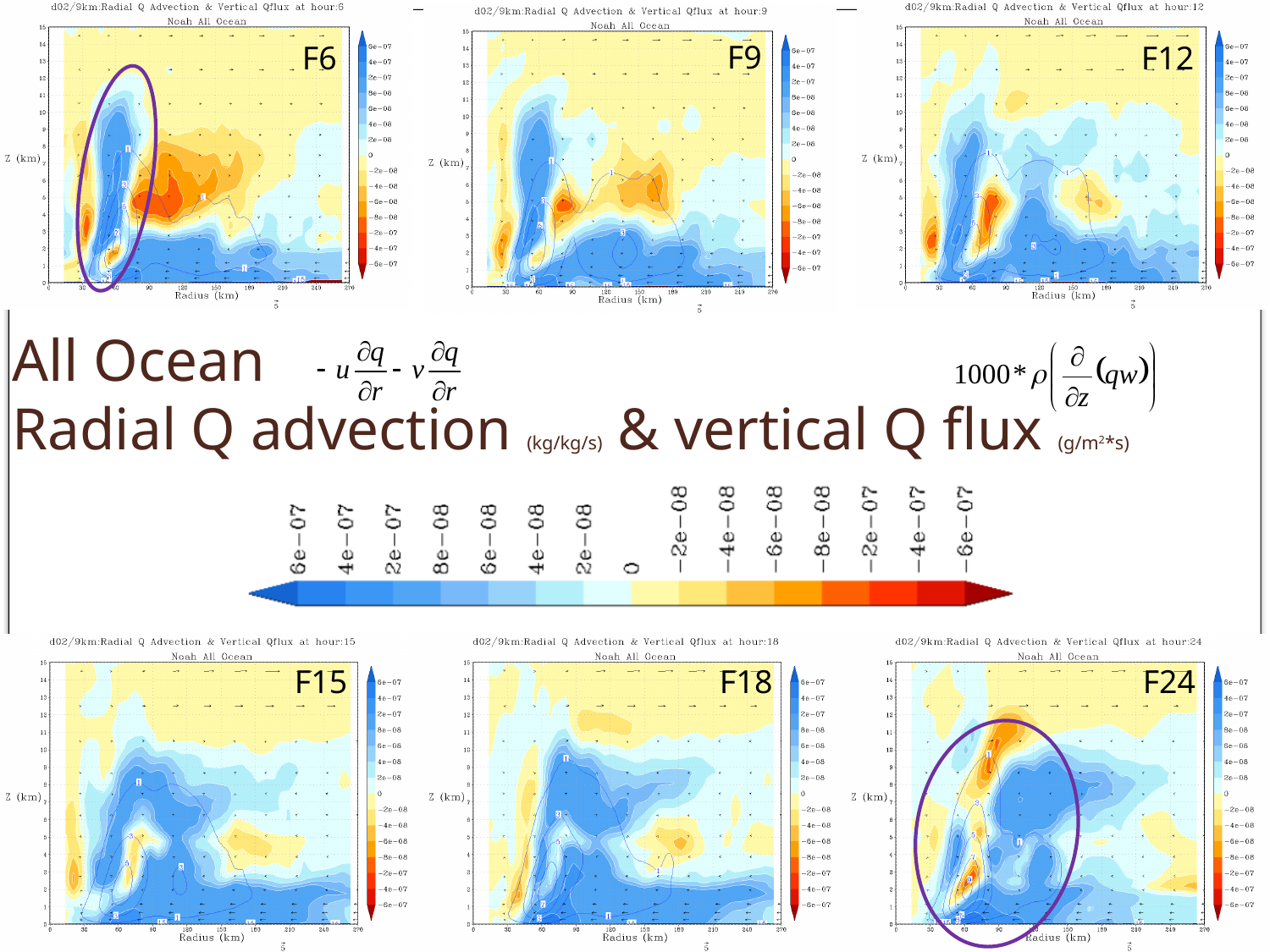
What forecast hour does the bottom-right panel (F24) correspond to, according to its title? hour:24 What is the lowest value shown on the large colour bar in the middle of the slide? -6e-07 What is the subtitle printed under the title of each panel? Noah All Ocean What is the maximum radius shown on the x axis of the panels? 270 What is the x-axis label on the panels? Radius (km) What kind of chart is each panel on the slide? Filled contour plot What forecast hour does the top-middle panel (F9) correspond to, according to its title? hour:9 How many chart panels are shown on the slide? 6 What units are given for vertical Q flux in the slide heading? g/m²*s Which two panels have a purple ellipse drawn on them? F6 and F24 What is the highest value shown on the large colour bar in the middle of the slide? 6e-07 What is the maximum height shown on the y axis of the panels? 15